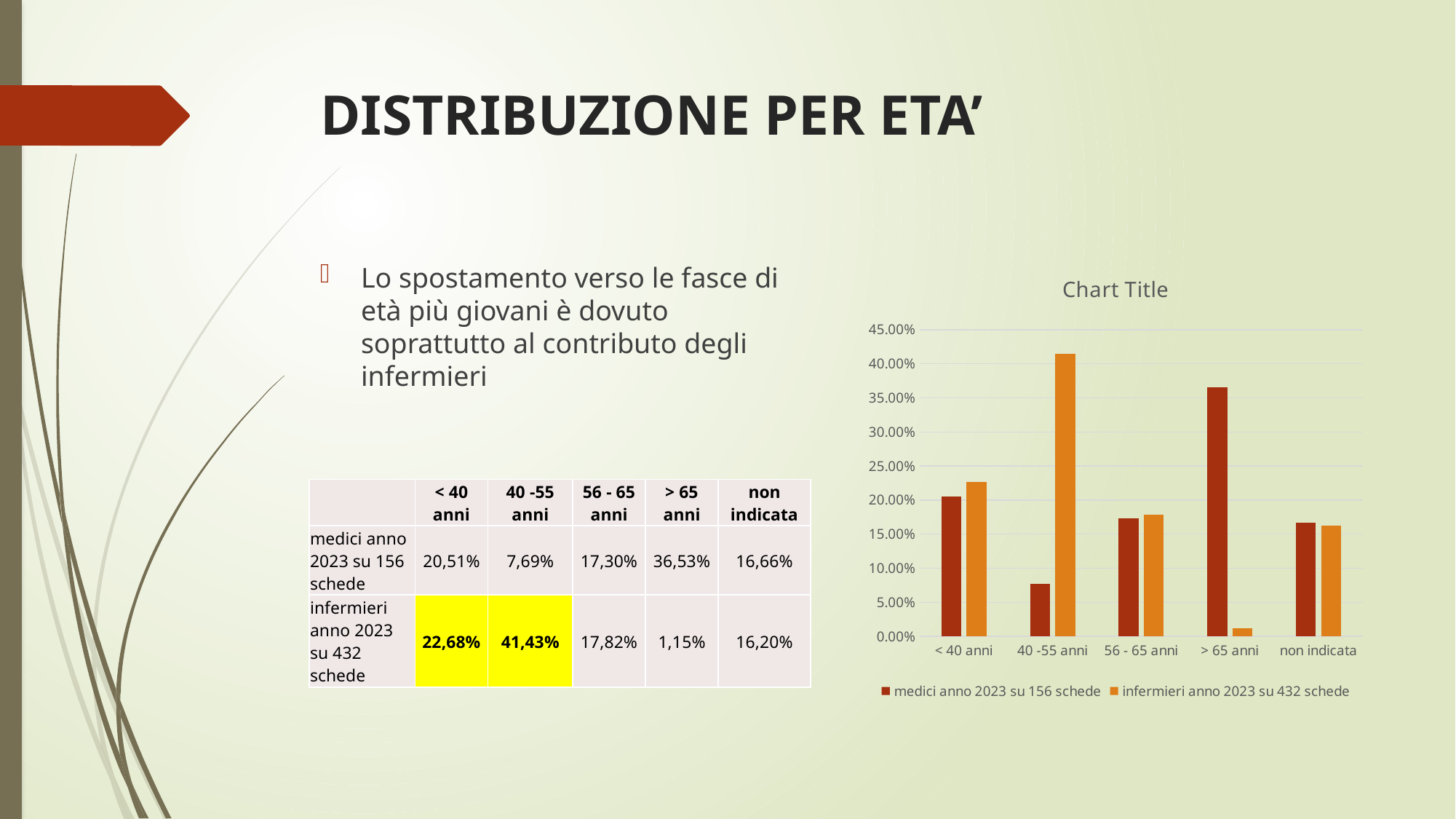
Is the value for 'infermieri anno 2023 su 432 schede' in the '40 -55 anni' category greater or less than 40.00%? greater In the '> 65 anni' category, which series has the larger value: 'medici anno 2023 su 156 schede' or 'infermieri anno 2023 su 432 schede'? medici anno 2023 su 156 schede What kind of chart is shown on the slide? bar chart Which age category has the lowest value for the series 'infermieri anno 2023 su 432 schede'? > 65 anni Which age category has the highest value for the series 'medici anno 2023 su 156 schede'? > 65 anni Which age category has the lowest value for the series 'medici anno 2023 su 156 schede'? 40 -55 anni How many series does the chart legend list? 2 What is the title shown above the chart? Chart Title What is the value for 'infermieri anno 2023 su 432 schede' in the '40 -55 anni' category, as printed in the table on the slide? 41,43% How many age categories are shown on the x axis of the chart? 5 Is the value for 'infermieri anno 2023 su 432 schede' in the '> 65 anni' category greater or less than 5.00%? less Which age category has the highest value for the series 'infermieri anno 2023 su 432 schede'? 40 -55 anni